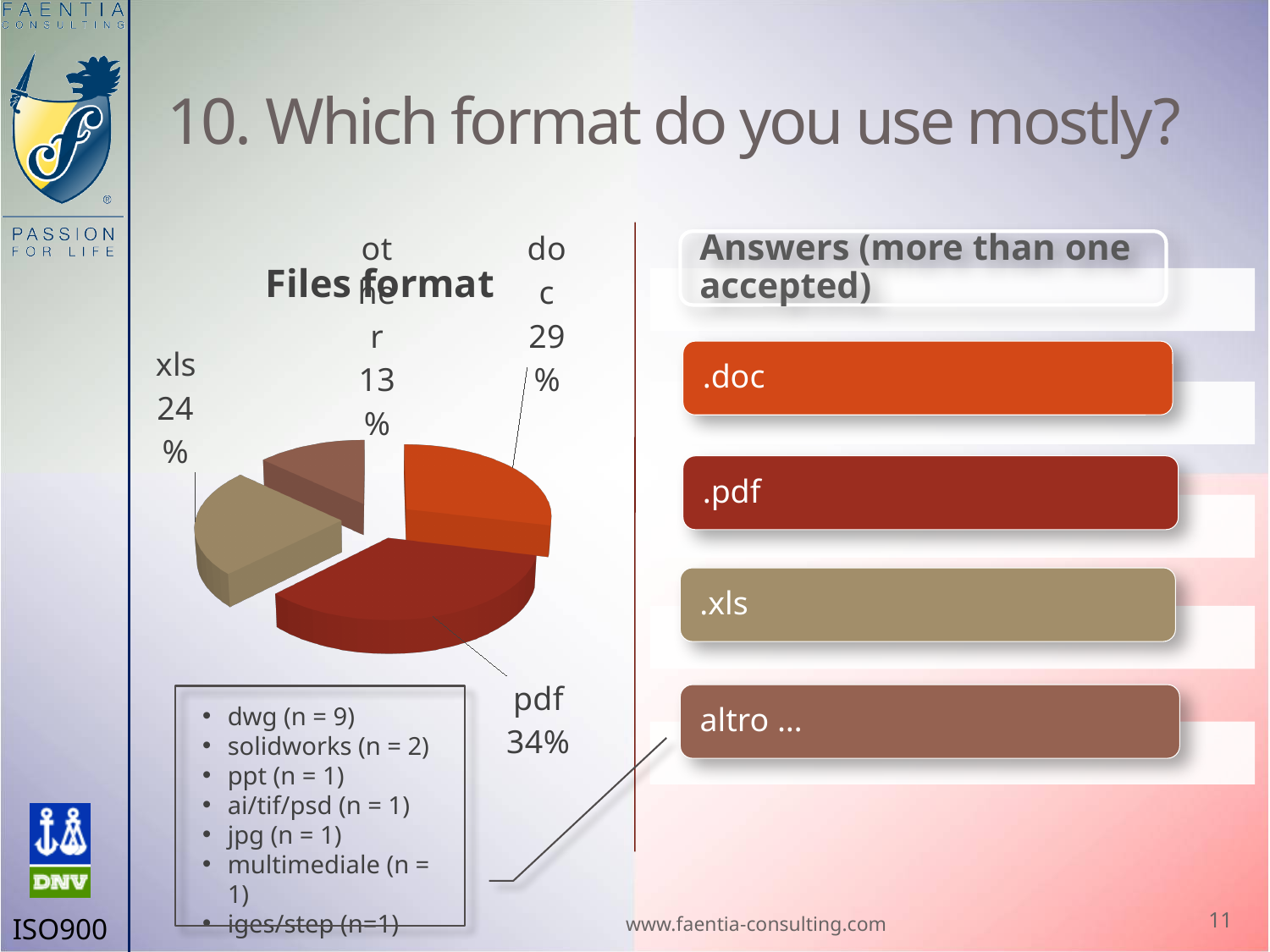
What share of the pie does pdf have? 34% What share of the pie does the 'other' slice have? 13% What type of chart is shown on the slide? pie chart What is the title of the chart? Files format Which file format has the largest slice of the pie? pdf What share of the pie does xls have? 24% Which slice of the pie is the smallest? other What is the difference in percentage points between the xls and other slices? 11 How many slices does the pie chart have? 4 What is the difference in percentage points between the pdf and doc slices? 5 Which slice is larger, xls or doc? doc What share of the pie does doc have? 29%